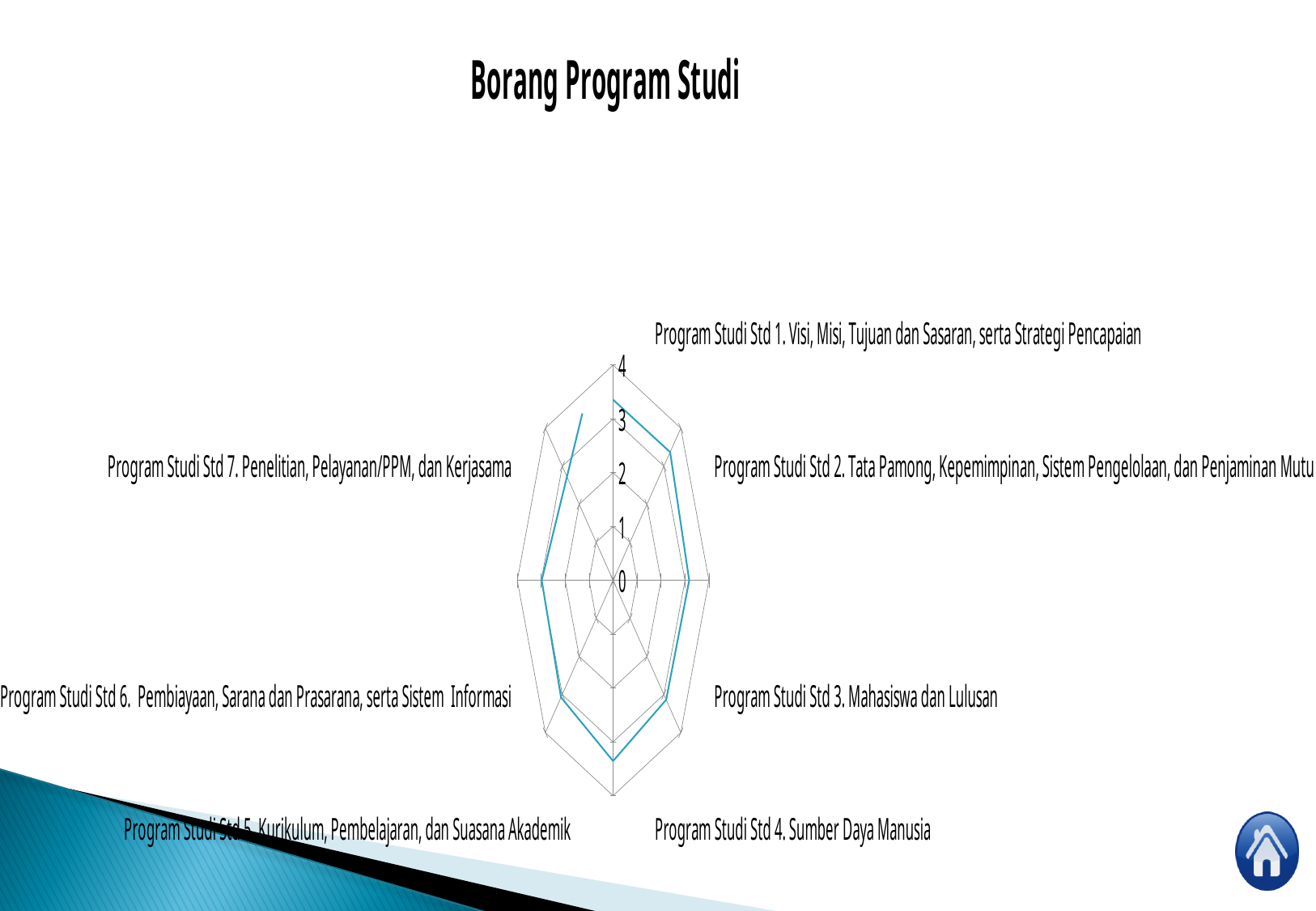
Is the value for Program Studi Std 2. Tata Pamong, Kepemimpinan, Sistem Pengelolaan, dan Penjaminan Mutu greater or less than 4? less What is the maximum value shown on the radar chart's axis scale? 4 What kind of chart is shown on the slide? radar chart How many categories (axes) does the radar chart have? 7 What is the title of the chart on the slide? Borang Program Studi Is the value for Program Studi Std 7. Penelitian, Pelayanan/PPM, dan Kerjasama greater or less than 4? less Is the value for Program Studi Std 5. Kurikulum, Pembelajaran, dan Suasana Akademik greater or less than 4? less